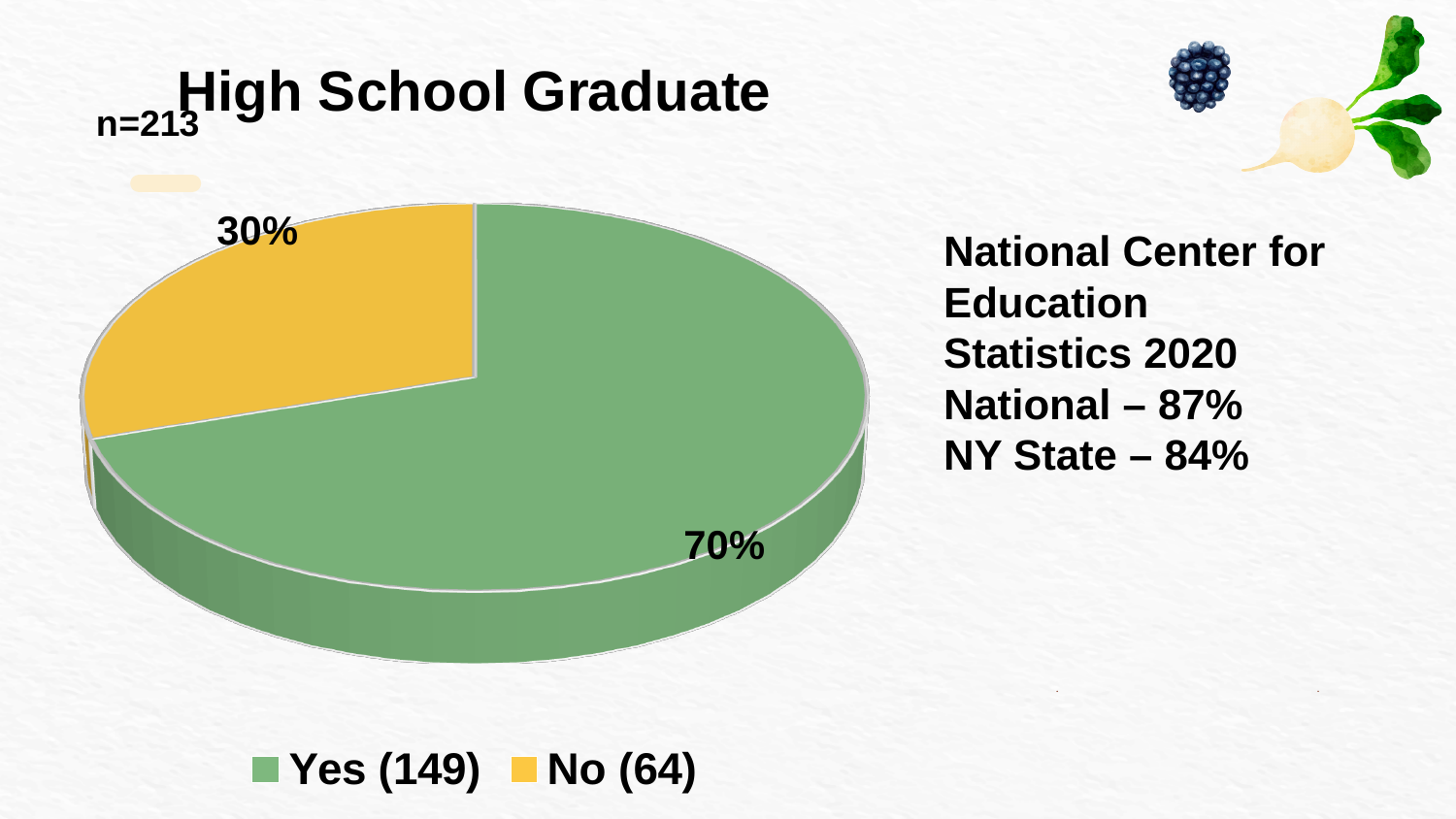
What percentage of the pie is the Yes (149) slice? 70% What is the difference in percentage points between the Yes (149) slice and the No (64) slice? 40 Which slice is the largest in the pie chart? Yes (149) What is the title of the chart? High School Graduate What is the sample size (n) shown on the slide? n=213 What kind of chart is shown on the slide? pie chart What colour is the Yes (149) slice? green How many entries does the legend list? 2 How many slices does the pie chart have? 2 Which slice is larger, Yes (149) or No (64)? Yes (149) Which slice is the smallest in the pie chart? No (64) What percentage of the pie is the No (64) slice? 30%